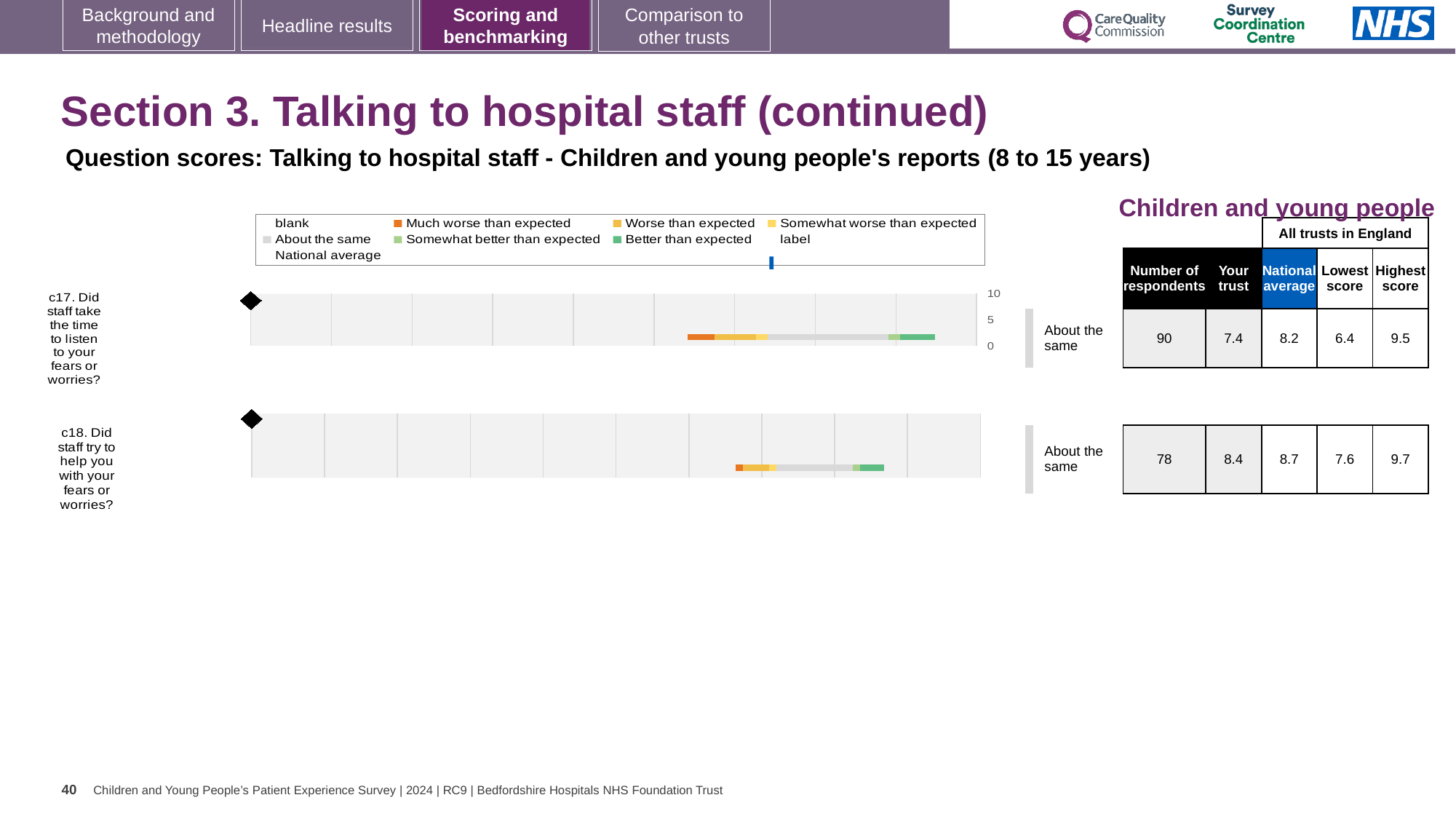
What is the highest score across all trusts in England for question c18? 9.7 How many questions (bars) are plotted on the slide? 2 For question c17 (Did staff take the time to listen to your fears or worries?), what is the 'Your trust' score? 7.4 What is the lowest score across all trusts in England for question c17? 6.4 What benchmark category is shown next to the bar for question c18? About the same Which question has the higher 'Your trust' score, c17 or c18? c18 What kind of chart is used to show the question scores on this slide? bar chart What is the difference between the national average and the trust's score for question c17? 0.8 What is the difference between the highest and lowest scores for question c18? 2.1 Is the trust's score for question c17 greater or less than 5 on the chart axis? greater For question c18 (Did staff try to help you with your fears or worries?), what is the national average score? 8.7 How many respondents answered question c17? 90